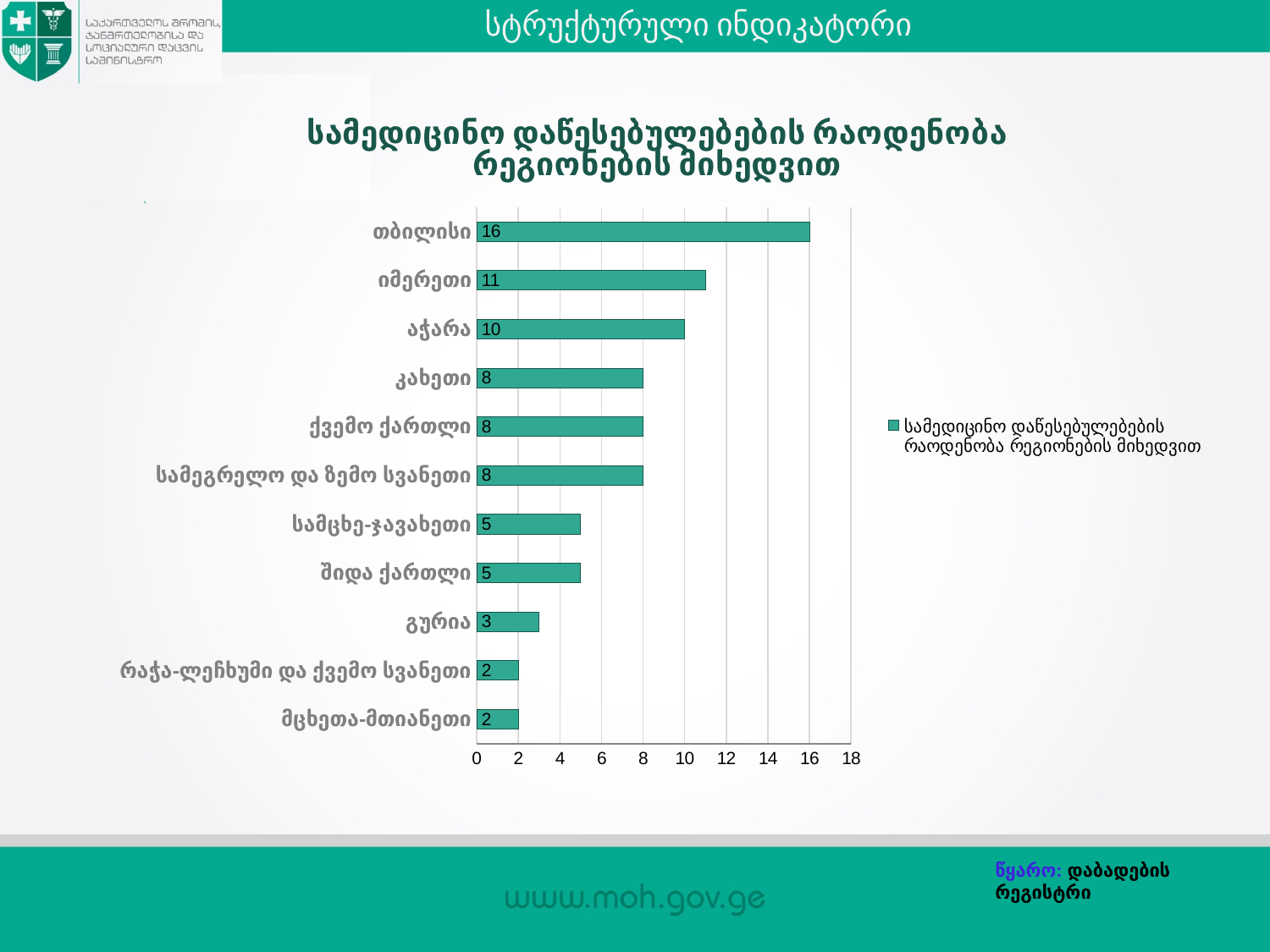
What is the title of the chart? სამედიცინო დაწესებულებების რაოდენობა რეგიონების მიხედვით Is the value for სამცხე-ჯავახეთი greater or less than 8? less How many series does the legend list? 1 What is the value for თბილისი? 16 What is the difference between the values for აჭარა and შიდა ქართლი? 5 What kind of chart is shown on the slide? bar chart What is the value for გურია? 3 Which region has the highest value? თბილისი What is the difference between the values for თბილისი and იმერეთი? 5 Which is larger, the value for იმერეთი or the value for კახეთი? იმერეთი What is the value for აჭარა? 10 How many regions are shown on the chart? 11